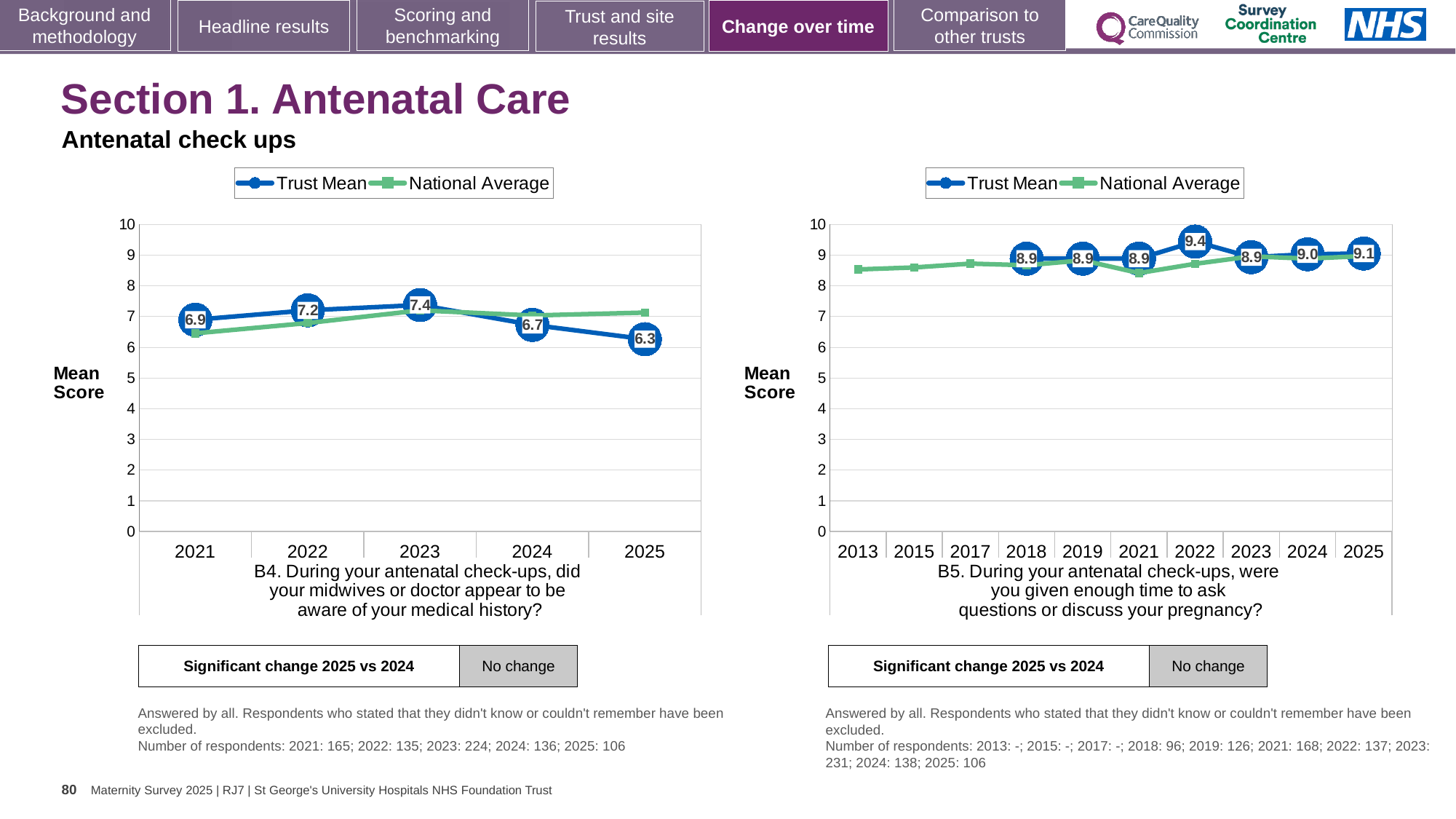
In the right chart (B5), what is the Trust Mean for 2022? 9.4 In the left chart (B4), what is the difference between the Trust Mean in 2023 and in 2025? 1.1 In the left chart (B4), what is the Trust Mean for 2025? 6.3 How many series does the legend of the left chart (B4) list? 2 In the right chart (B5), which year has the highest Trust Mean? 2022 In the right chart (B5), is the Trust Mean for 2024 or for 2025 larger? 2025 In the left chart (B4), which year has the highest Trust Mean? 2023 In the right chart (B5), is the National Average for 2013 greater or less than 8? greater In the left chart (B4), which year has the lowest Trust Mean? 2025 In the left chart (B4), what is the Trust Mean for 2023? 7.4 In the left chart (B4), does the Trust Mean rise or fall from 2023 to 2025? fall How many years are shown on the x axis of the right chart (B5)? 10